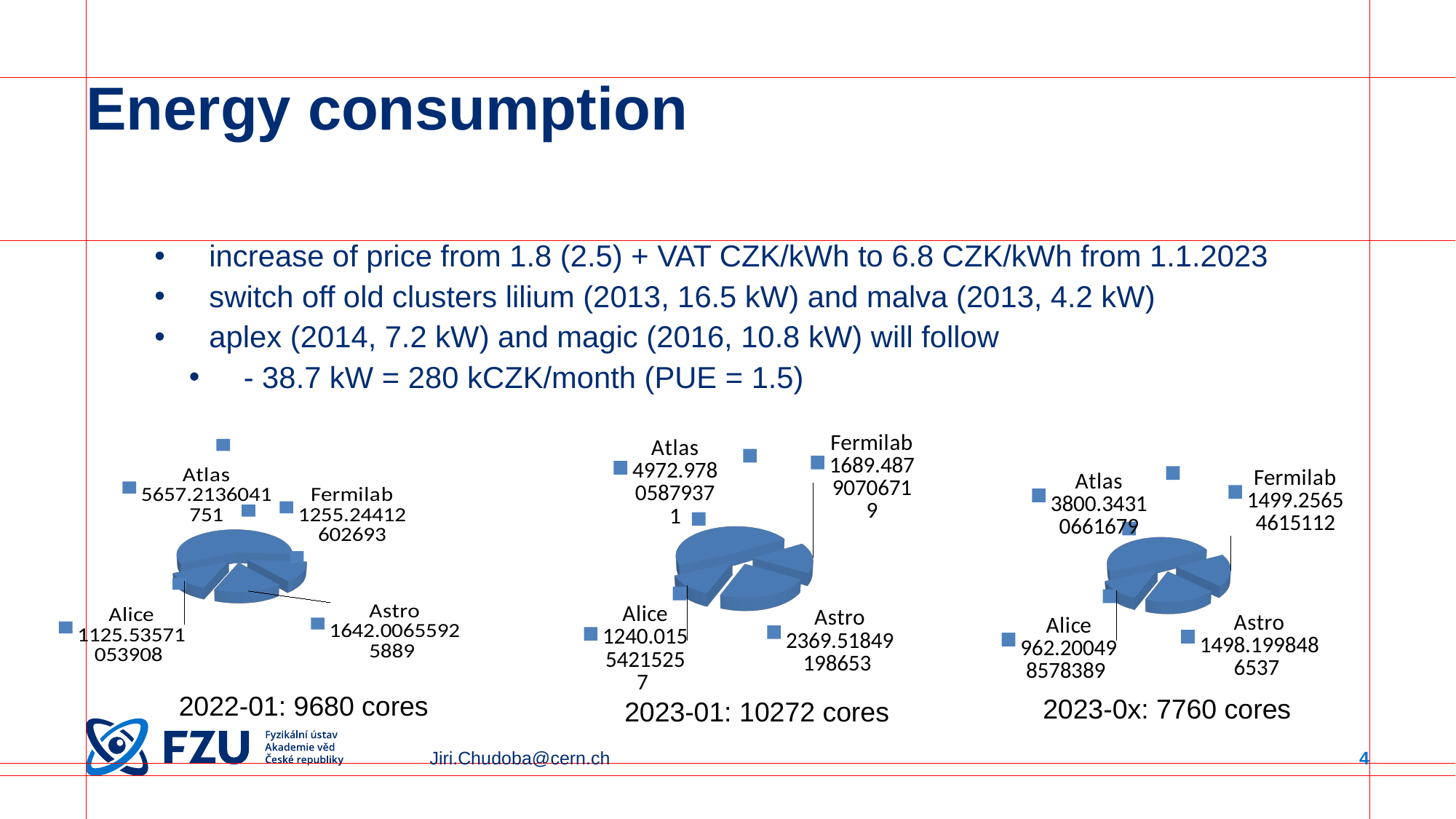
In the 2023-01 pie chart, which labeled category has the smallest value? Alice In the 2022-01 pie chart, which is larger, Astro or Fermilab? Astro In the 2023-01 pie chart, what is the value for Alice? 1240.01554215257 In the 2023-0x pie chart, what is the value for Atlas? 3800.34310661679 In the 2022-01 pie chart, what is the value for Atlas? 5657.2136041751 In the 2023-0x pie chart, which is larger, Atlas or Astro? Atlas In the 2022-01 pie chart, what is the value for Fermilab? 1255.24412602693 In the 2022-01 pie chart, which labeled category has the largest value? Atlas In the 2023-01 pie chart, what is the value for Astro? 2369.51849198653 How many cores does the caption under the 2023-01 pie chart state? 10272 cores In the 2023-0x pie chart, what is the value for Alice? 962.200498578389 What kind of chart is used for the 2022-01 data? Pie chart